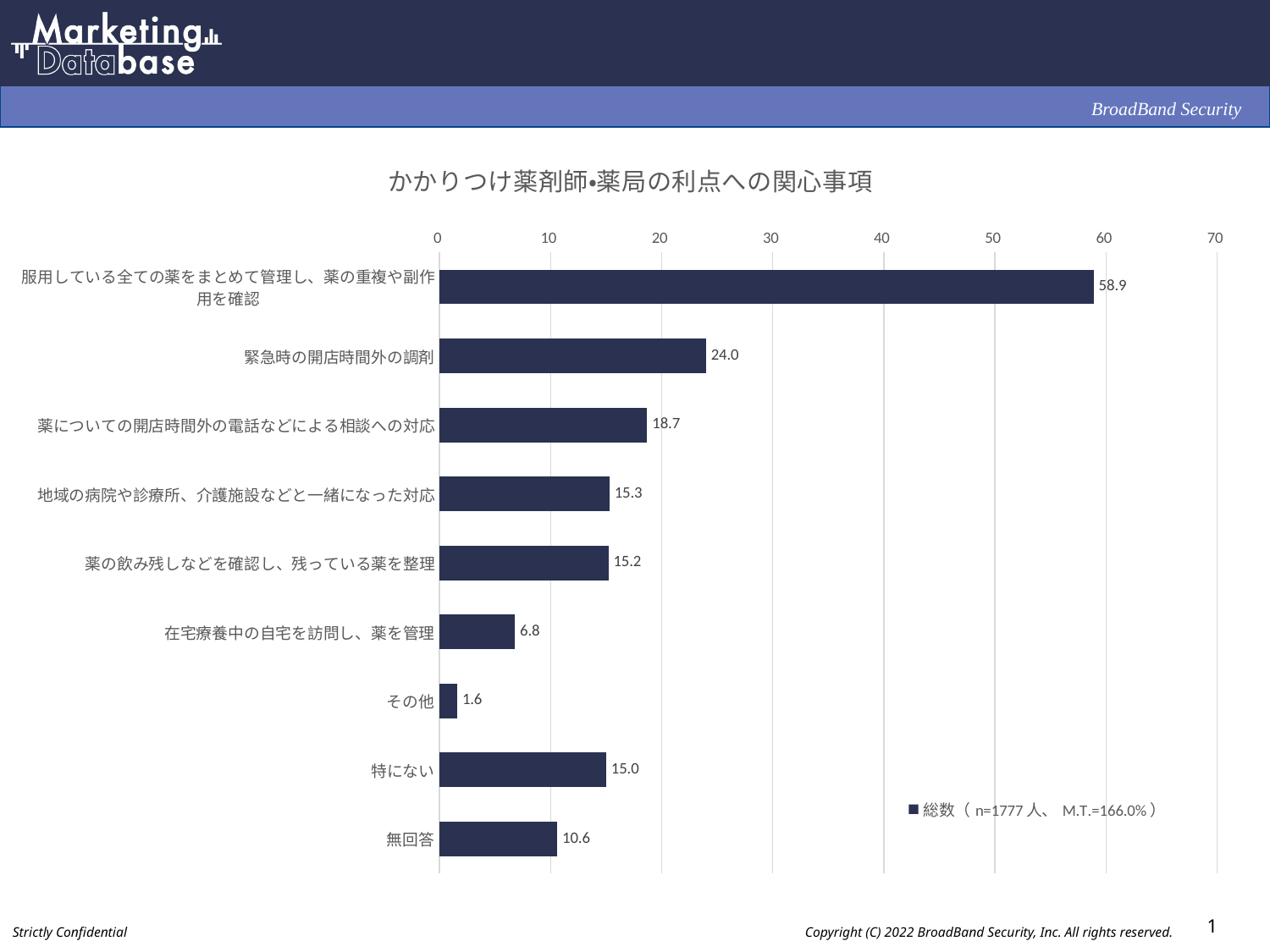
What is the difference between the values for 緊急時の開店時間外の調剤 and 薬についての開店時間外の電話などによる相談への対応? 5.3 What is the value for 在宅療養中の自宅を訪問し、薬を管理? 6.8 Which category has the highest value? 服用している全ての薬をまとめて管理し、薬の重複や副作用を確認 Which is larger, the value for 特にない or the value for 無回答? 特にない How many series does the legend list? 1 What is the value for 無回答? 10.6 What kind of chart is shown on the slide? bar chart What is the value for 緊急時の開店時間外の調剤? 24.0 What is the title of the chart? かかりつけ薬剤師•薬局の利点への関心事項 How many categories are shown in the chart? 9 Is the value for 服用している全ての薬をまとめて管理し、薬の重複や副作用を確認 greater or less than 50? greater Which category has the lowest value? その他